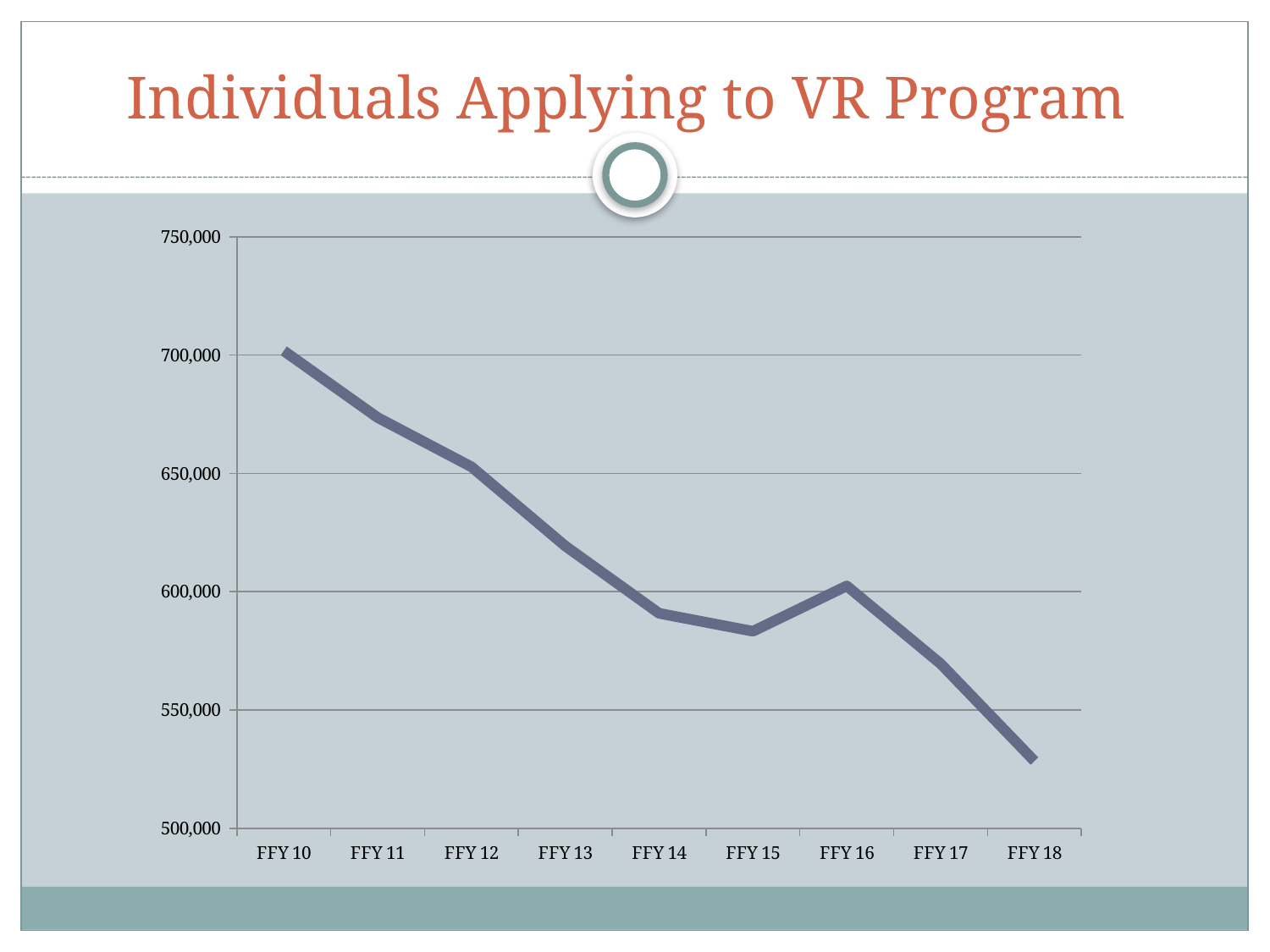
Which is larger, the value for FFY 15 or the value for FFY 16? FFY 16 Is the value for FFY 18 greater or less than 550,000? less Which fiscal year has the lowest number of individuals applying? FFY 18 Is the value for FFY 17 greater or less than 550,000? greater Overall, do the values rise or fall from FFY 10 to FFY 18? Fall What kind of chart is shown on the slide? Line chart Which fiscal year has the highest number of individuals applying? FFY 10 Is the value for FFY 13 greater or less than 650,000? less What is the title of the chart? Individuals Applying to VR Program Which is larger, the value for FFY 13 or the value for FFY 14? FFY 13 How many fiscal years are plotted on the x axis? 9